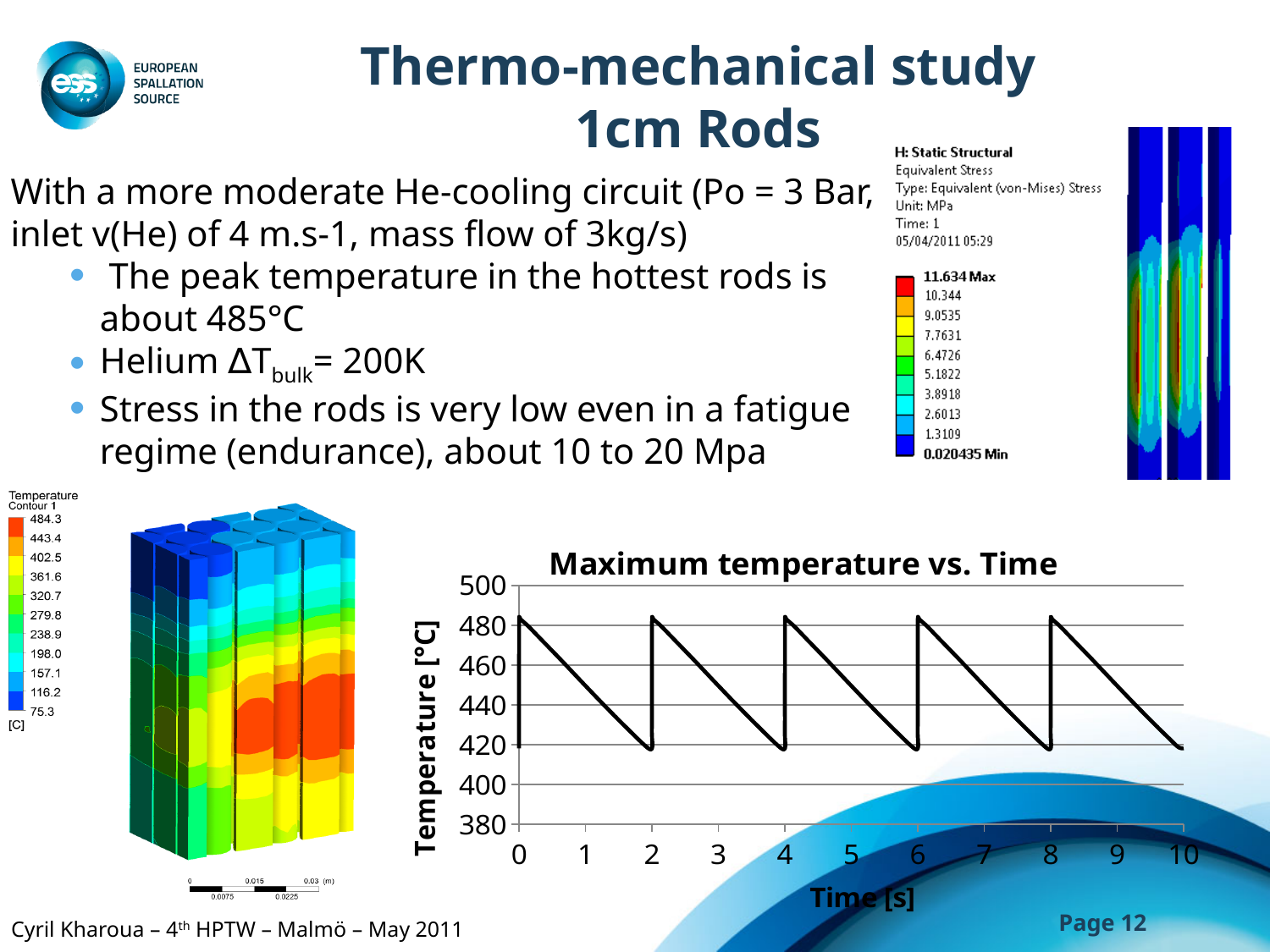
In the 'Maximum temperature vs. Time' chart, what is the label of the y axis? Temperature [°C] What is the title of the chart at the bottom right of the slide? Maximum temperature vs. Time In the 'Maximum temperature vs. Time' chart, is the peak temperature greater or less than 460? greater In the 'Maximum temperature vs. Time' chart, is the peak temperature greater or less than 500? less What kind of chart is 'Maximum temperature vs. Time'? line chart In the 'Maximum temperature vs. Time' chart, is the lowest temperature reached greater or less than 400? greater In the 'Maximum temperature vs. Time' chart, how many temperature peaks are shown over the 10 s? 5 In the 'Maximum temperature vs. Time' chart, between time 0 and time 2 s, does the temperature rise or fall? fall In the 'Maximum temperature vs. Time' chart, what is the highest value shown on the x axis? 10